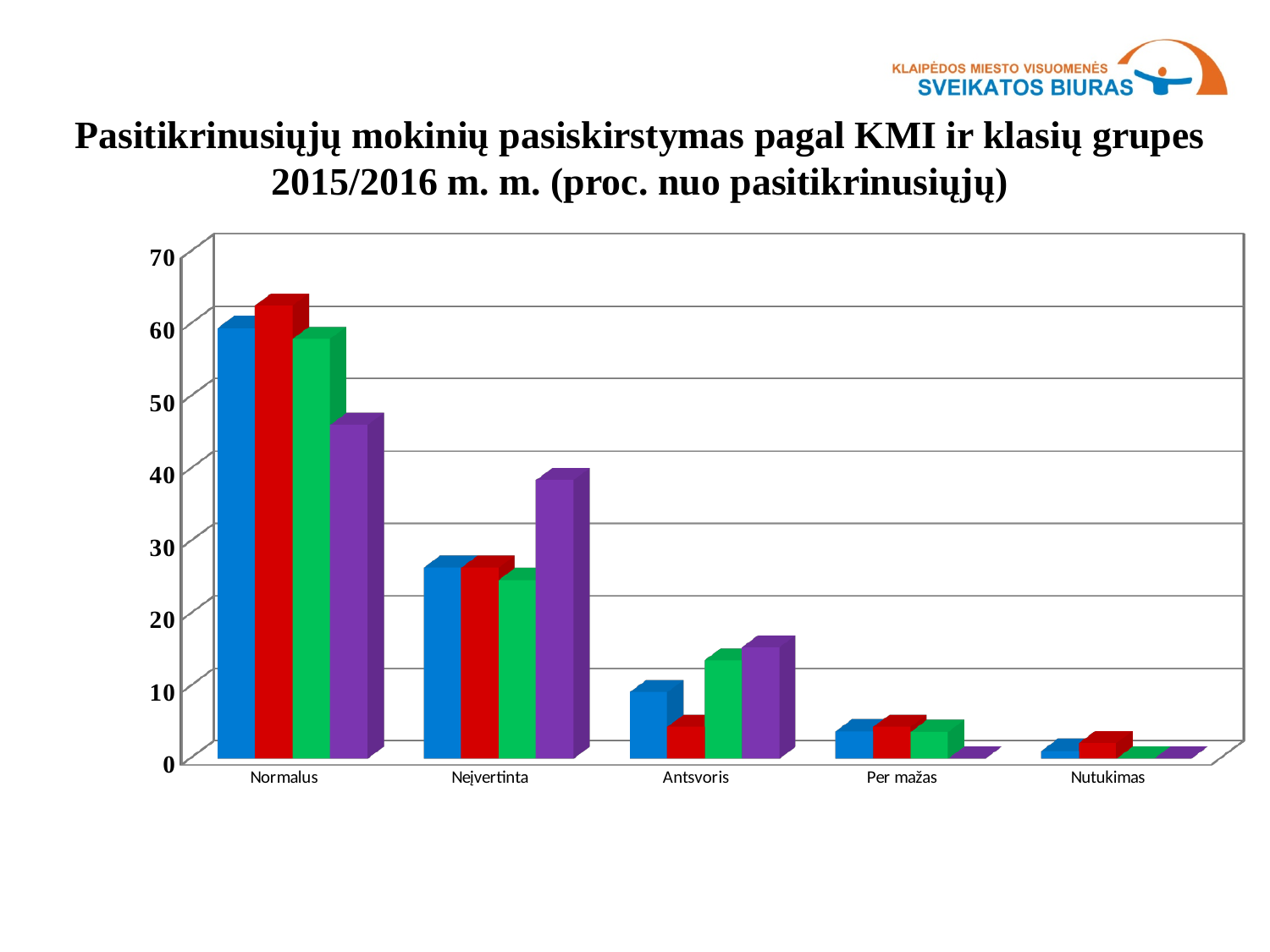
For Normalus, which is larger: the blue bar or the purple bar? the blue bar Is the value of the purple bar for Normalus greater or less than 50? less How many bars are shown for each category in the chart? 4 Is the value of the blue bar for Normalus greater or less than 50? greater Which category has the tallest bars in the chart? Normalus Is the value of the red bar for Antsvoris greater or less than 10? less How many categories are shown on the x axis of the chart? 5 What kind of chart is shown on the slide? bar chart For Neįvertinta, which is larger: the purple bar or the blue bar? the purple bar Which category has the lowest bars in the chart? Nutukimas